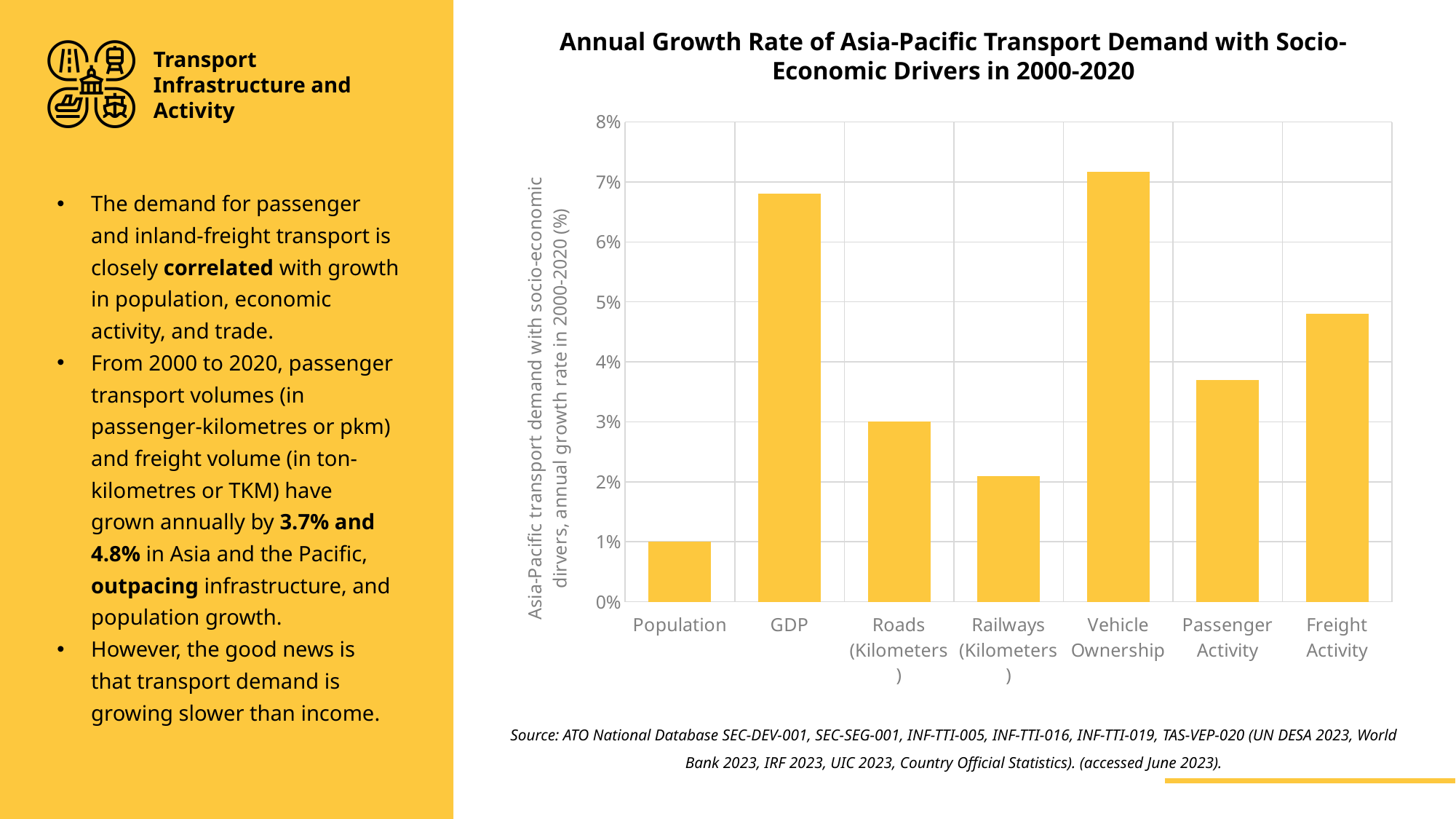
What is the title of the chart? Annual Growth Rate of Asia-Pacific Transport Demand with Socio-Economic Drivers in 2000-2020 Is the value for GDP greater or less than 6%? greater Is the value for Vehicle Ownership greater or less than 7%? greater Which category has the lowest annual growth rate in the chart? Population What is the annual growth rate shown for Population? 1% Is the value for Passenger Activity greater or less than 4%? less How many categories are shown on the x axis of the chart? 7 What kind of chart is shown on the slide? bar chart What is the annual growth rate shown for Roads (Kilometers)? 3% Which category has the highest annual growth rate in the chart? Vehicle Ownership Which has the larger annual growth rate, Freight Activity or Passenger Activity? Freight Activity